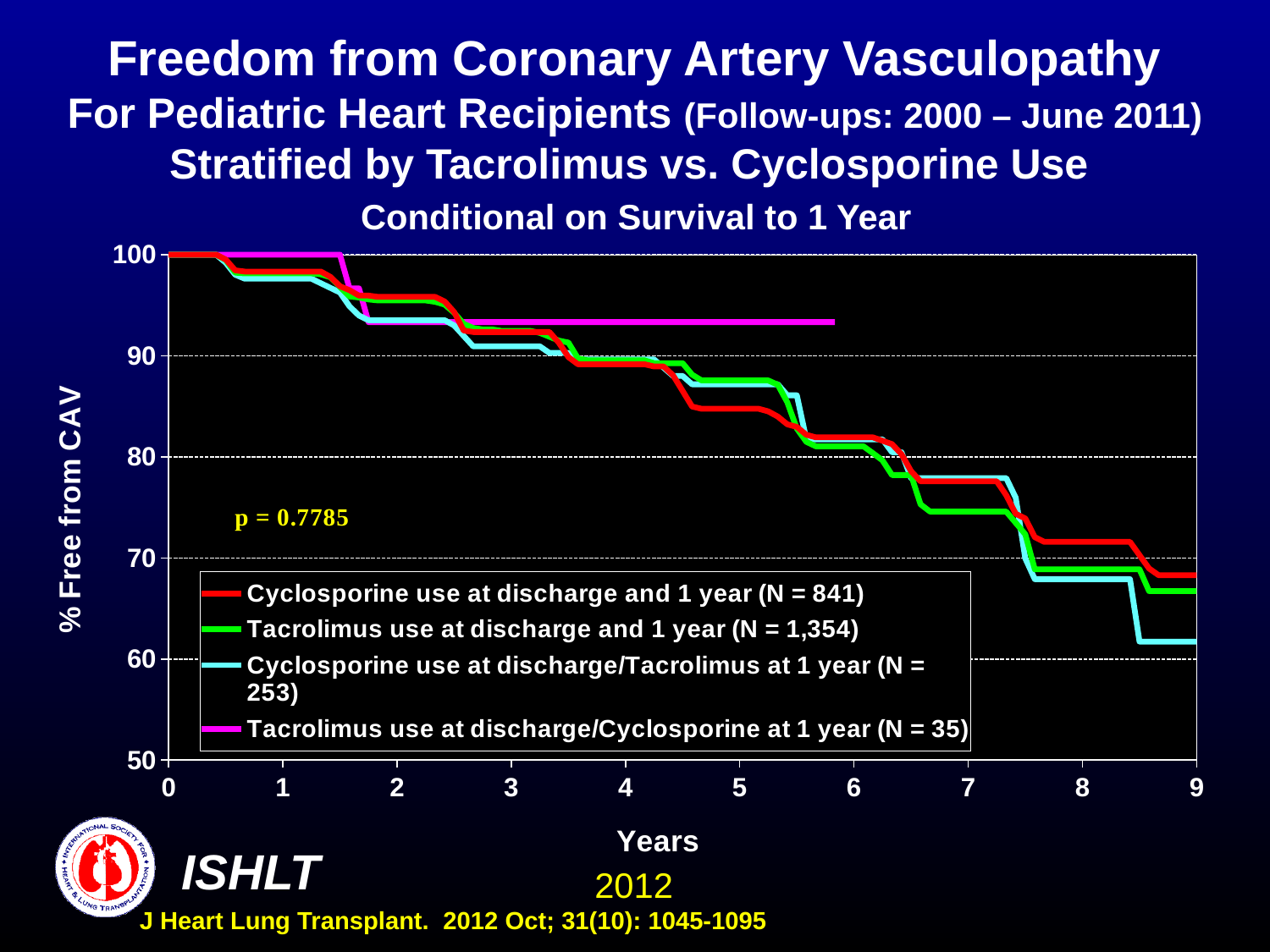
What p-value is printed on the chart? p = 0.7785 How many series does the legend list? 4 Is the value for the 'Cyclosporine use at discharge/Tacrolimus at 1 year' curve at year 9 greater or less than 70? less Is the value for the 'Cyclosporine use at discharge and 1 year' curve at year 2 greater or less than 90? greater At year 9, which curve is higher: 'Cyclosporine use at discharge and 1 year' or 'Cyclosporine use at discharge/Tacrolimus at 1 year'? Cyclosporine use at discharge and 1 year What kind of chart is shown on the slide? line chart Is the value for the 'Tacrolimus use at discharge/Cyclosporine at 1 year' curve at year 5 greater or less than 90? greater At year 5, which curve is higher: 'Tacrolimus use at discharge/Cyclosporine at 1 year' or 'Cyclosporine use at discharge and 1 year'? Tacrolimus use at discharge/Cyclosporine at 1 year Which curve has the lowest value at year 9? Cyclosporine use at discharge/Tacrolimus at 1 year Do the curves rise or fall as years increase along the x axis? fall According to the legend, what is N for the 'Cyclosporine use at discharge and 1 year' group? 841